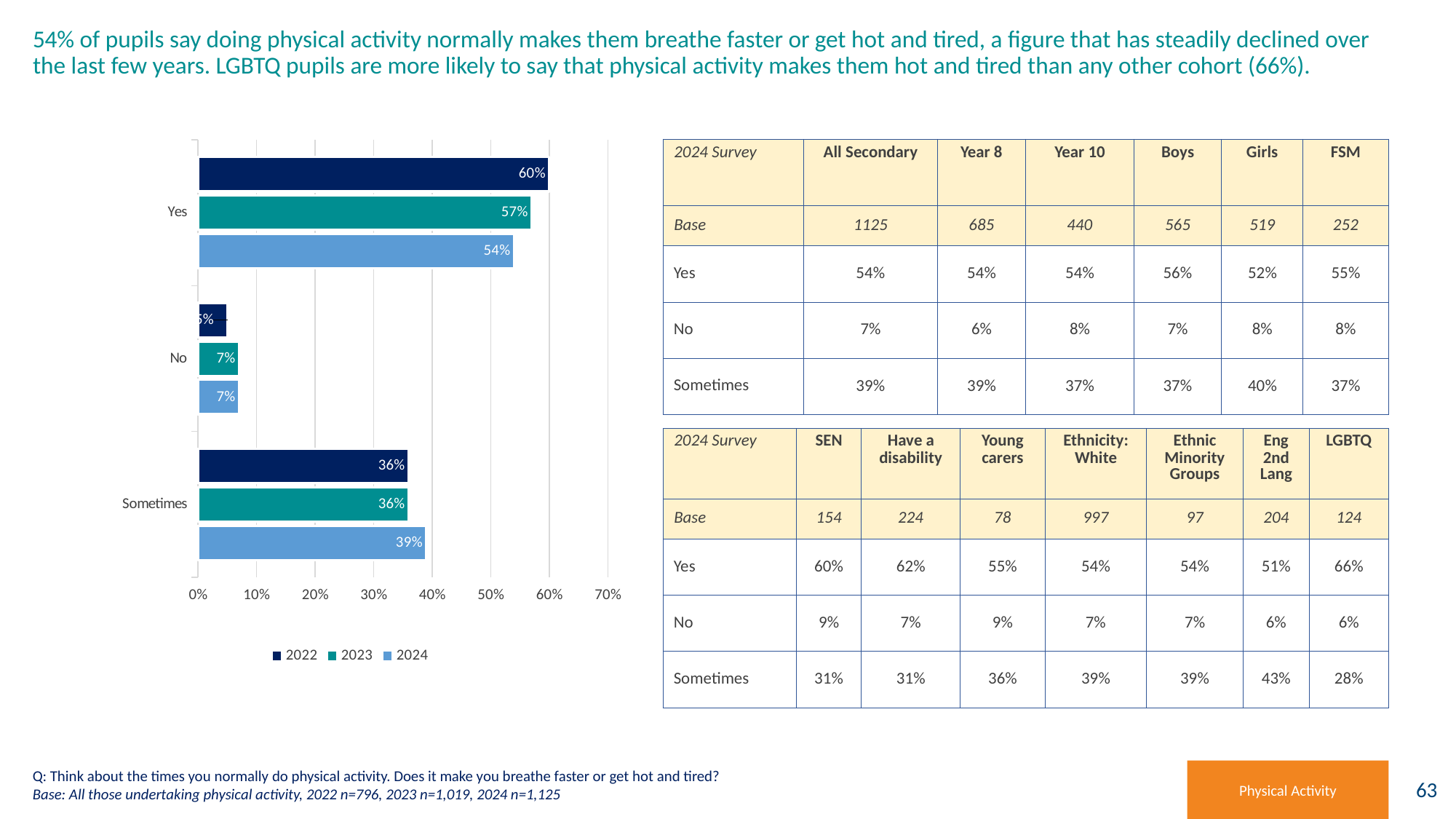
In the bar chart, is the value for 'No' in 2022 greater or less than 10%? less What kind of chart is shown on the left of the slide? bar chart In the bar chart, does the 'Yes' value rise or fall from 2022 to 2024? fall In the bar chart, what is the difference between the 'Yes' values for 2022 and 2024? 6% How many series does the legend of the bar chart list? 3 In the bar chart, what is the value for 'Yes' in 2024? 54% In the bar chart, what is the value for 'Sometimes' in 2024? 39% How many categories are shown on the bar chart's vertical axis? 3 In the bar chart, which category has the highest value for 2024? Yes In the bar chart, what is the value for 'Yes' in 2022? 60% In the bar chart, what is the value for 'No' in 2023? 7% In the bar chart, which category has the lowest value for 2023? No